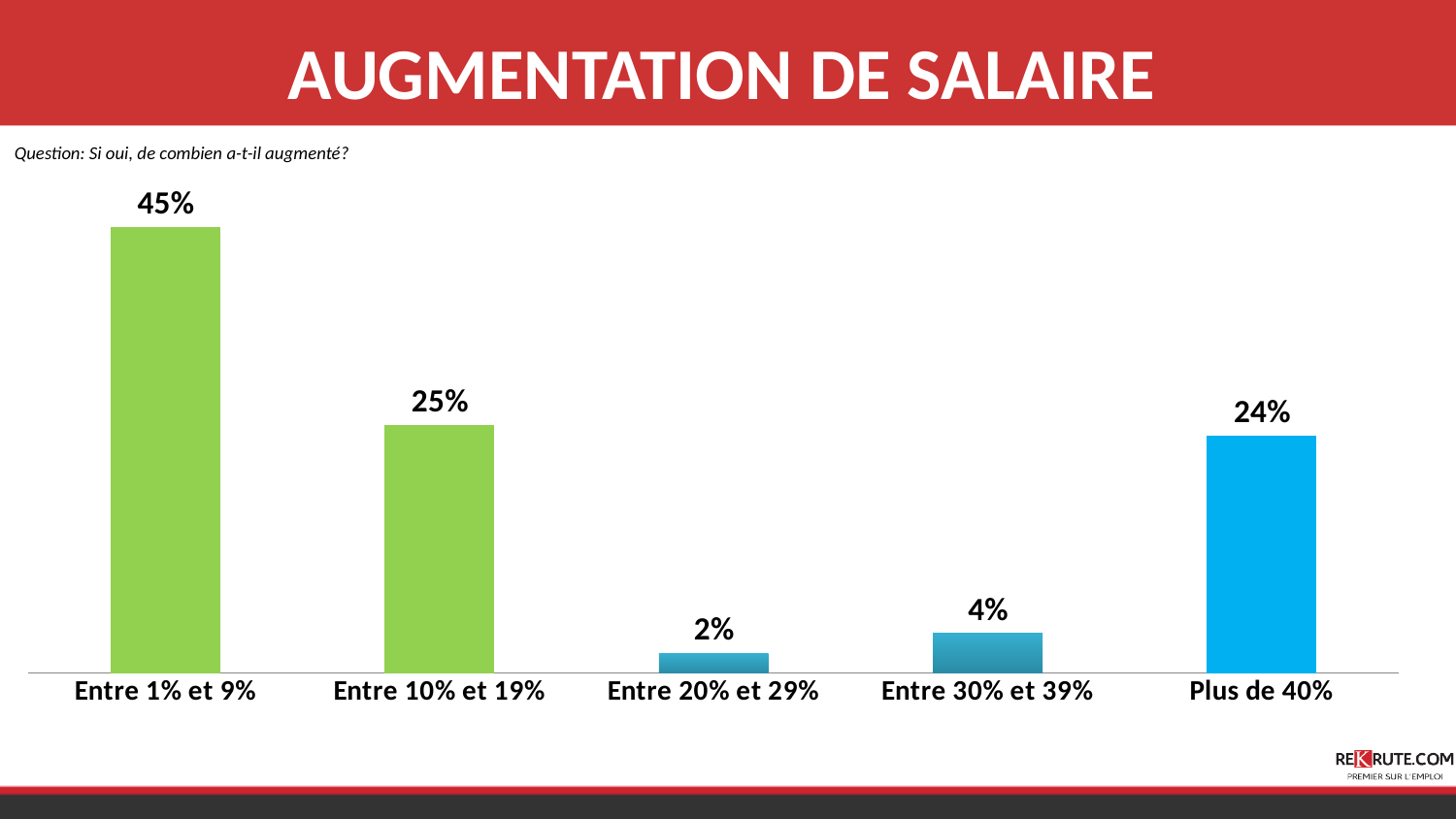
What is the difference between the values for "Entre 1% et 9%" and "Entre 10% et 19%"? 20% Which category has the highest value? Entre 1% et 9% What is the value for "Entre 1% et 9%"? 45% What is the title of the slide containing the chart? AUGMENTATION DE SALAIRE Which category has the lowest value? Entre 20% et 29% What is the value for "Entre 10% et 19%"? 25% What is the value for "Entre 20% et 29%"? 2% What is the value for "Entre 30% et 39%"? 4% What is the value for "Plus de 40%"? 24% What kind of chart is shown on the slide? Bar chart How many categories are shown in the chart? 5 Which is larger, the value for "Entre 10% et 19%" or the value for "Plus de 40%"? Entre 10% et 19%